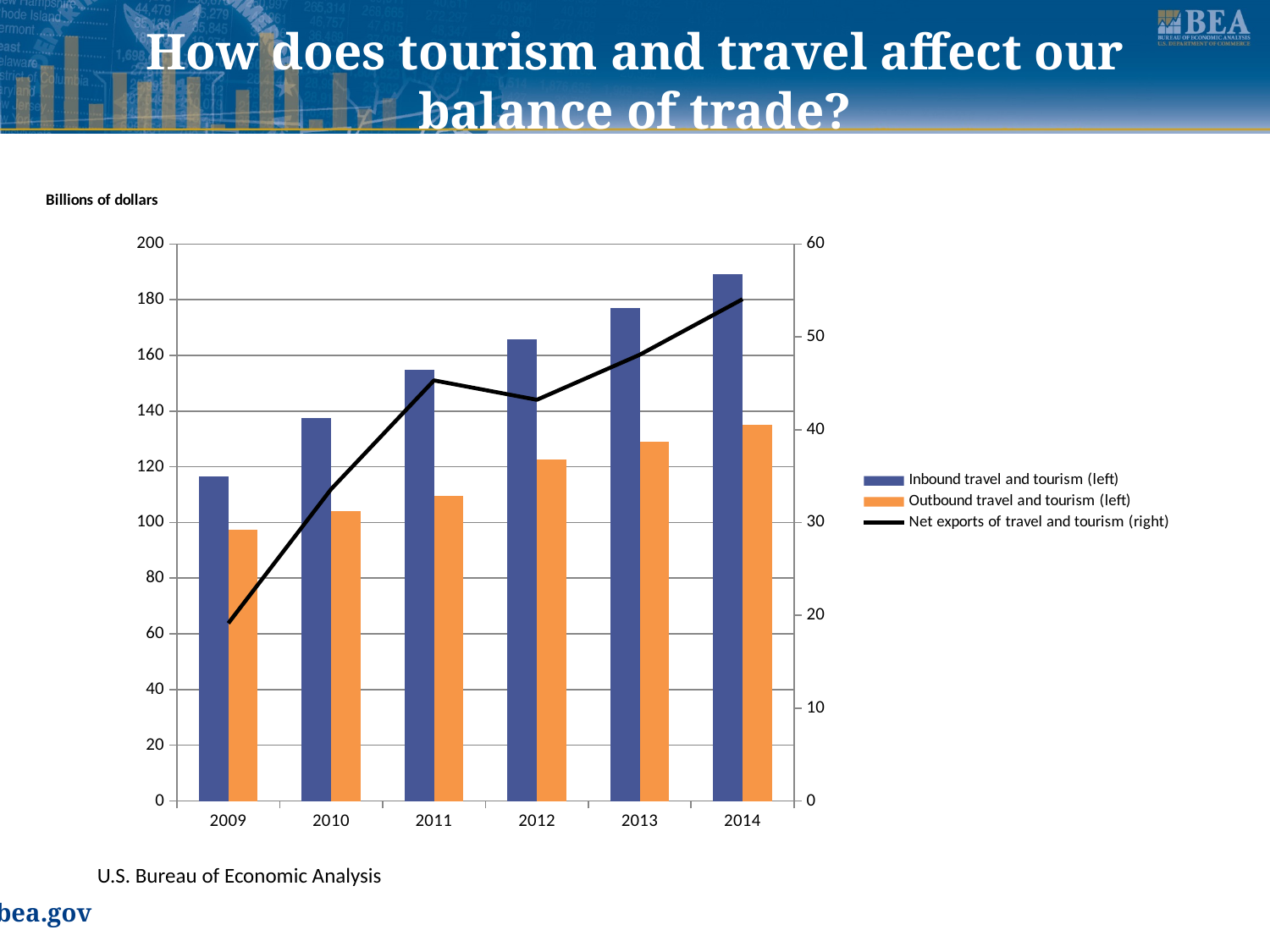
Is the value for Outbound travel and tourism in 2009 greater or less than 100? less Which year has the highest value for Inbound travel and tourism? 2014 What unit label is shown above the chart? Billions of dollars Which year has the lowest value for Outbound travel and tourism? 2009 In 2012, which is larger: Inbound travel and tourism or Outbound travel and tourism? Inbound travel and tourism How many series does the legend list? 3 Do the values for Inbound travel and tourism rise or fall from 2009 to 2014? rise Which year has the lowest value for Inbound travel and tourism? 2009 What kind of chart is shown on the slide? bar chart with a line How many years are shown on the x axis? 6 Is the value for Inbound travel and tourism in 2014 greater or less than 180? greater Is the value for Net exports of travel and tourism in 2014 greater or less than 50 on the right axis? greater